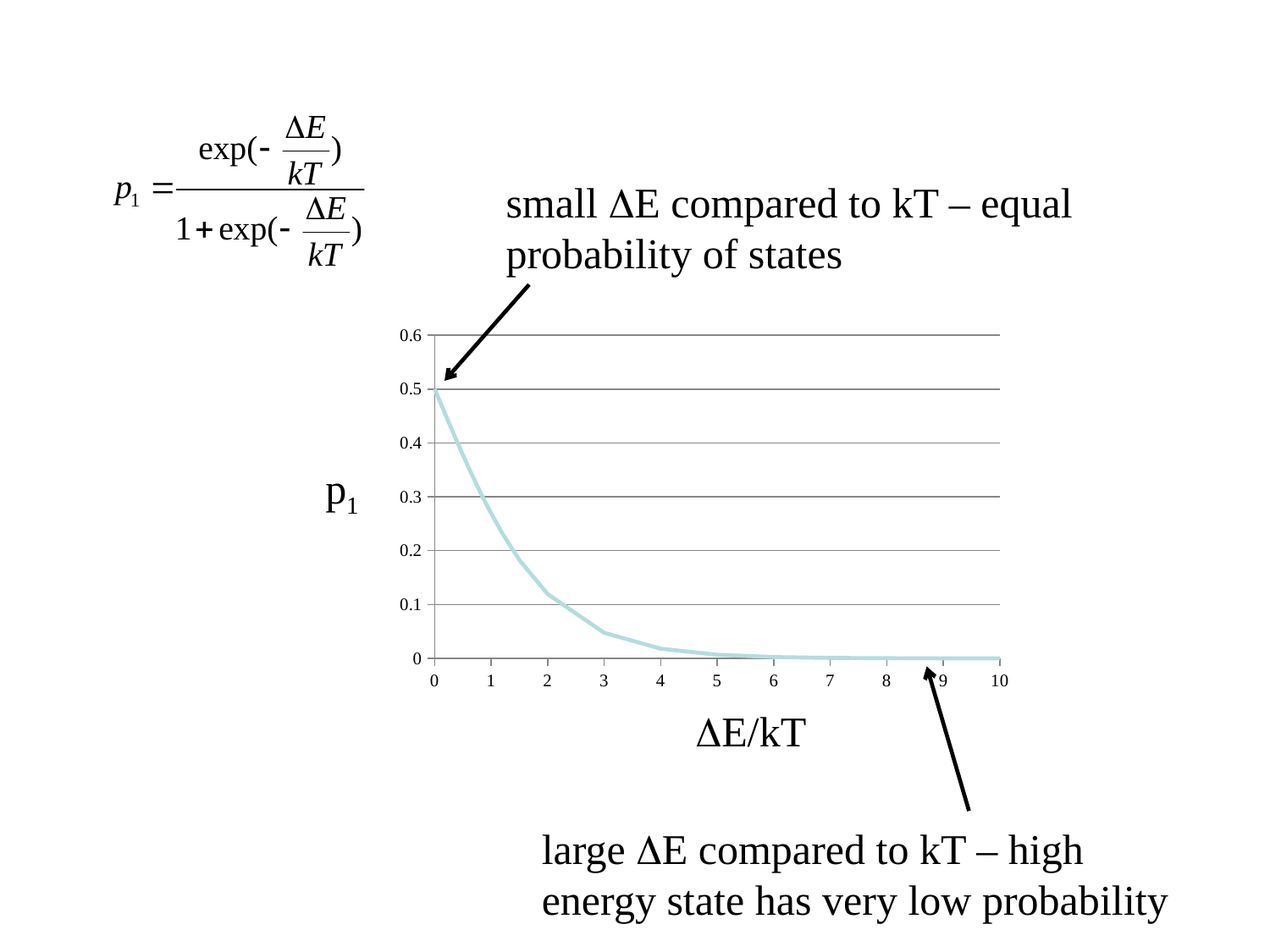
What is the label on the y axis of the chart? p1 What is the label on the x axis of the chart? ΔE/kT Is the value of p1 at ΔE/kT = 3 greater or less than 0.1? less Is the value of p1 at ΔE/kT = 1 greater or less than 0.2? greater Does p1 rise or fall as ΔE/kT increases? fall What is the value of p1 at ΔE/kT = 0? 0.5 Which is larger, p1 at ΔE/kT = 1 or p1 at ΔE/kT = 3? ΔE/kT = 1 At which value of ΔE/kT is p1 highest? 0 Is the value of p1 at ΔE/kT = 1 greater or less than 0.4? less What kind of chart is shown on the slide? line chart What is the highest value shown on the y axis? 0.6